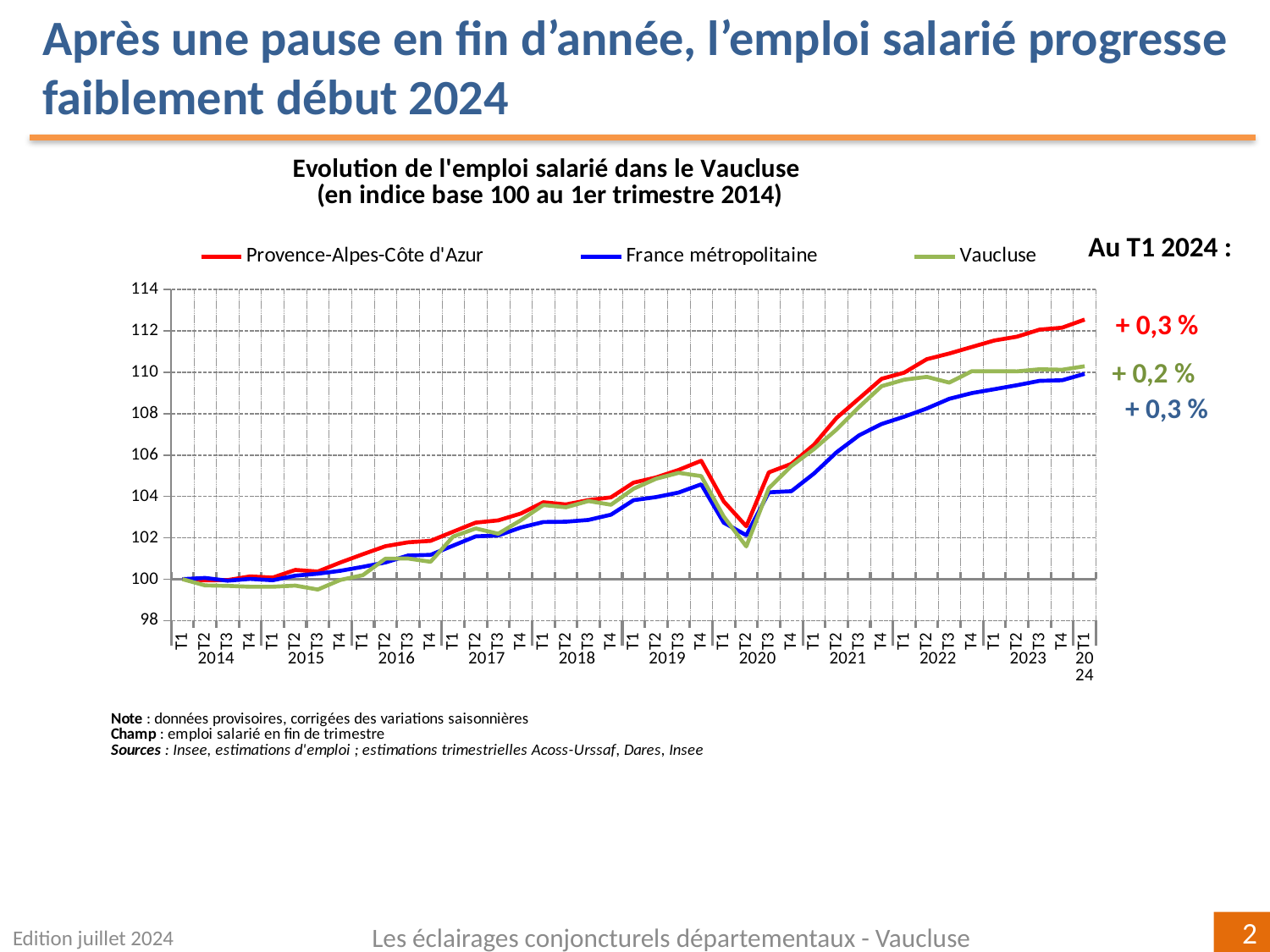
At T1 2024, which is higher: Provence-Alpes-Côte d'Azur or France métropolitaine? Provence-Alpes-Côte d'Azur Is the value for Provence-Alpes-Côte d'Azur at T1 2024 greater or less than 110? greater What change is annotated for Vaucluse at T1 2024? + 0,2 % What kind of chart is shown on the slide? line chart Which series are listed in the legend? Provence-Alpes-Côte d'Azur, France métropolitaine, Vaucluse How many series does the legend list? 3 Is the value for Vaucluse at T2 2020 greater or less than 102? less Which series has the highest value at T1 2024? Provence-Alpes-Côte d'Azur What is the title of the chart? Evolution de l'emploi salarié dans le Vaucluse (en indice base 100 au 1er trimestre 2014) What change is annotated for Provence-Alpes-Côte d'Azur at T1 2024? + 0,3 % Overall, does the France métropolitaine series rise or fall from T1 2014 to T1 2024? rise Which series has the lowest value at T2 2020? Vaucluse